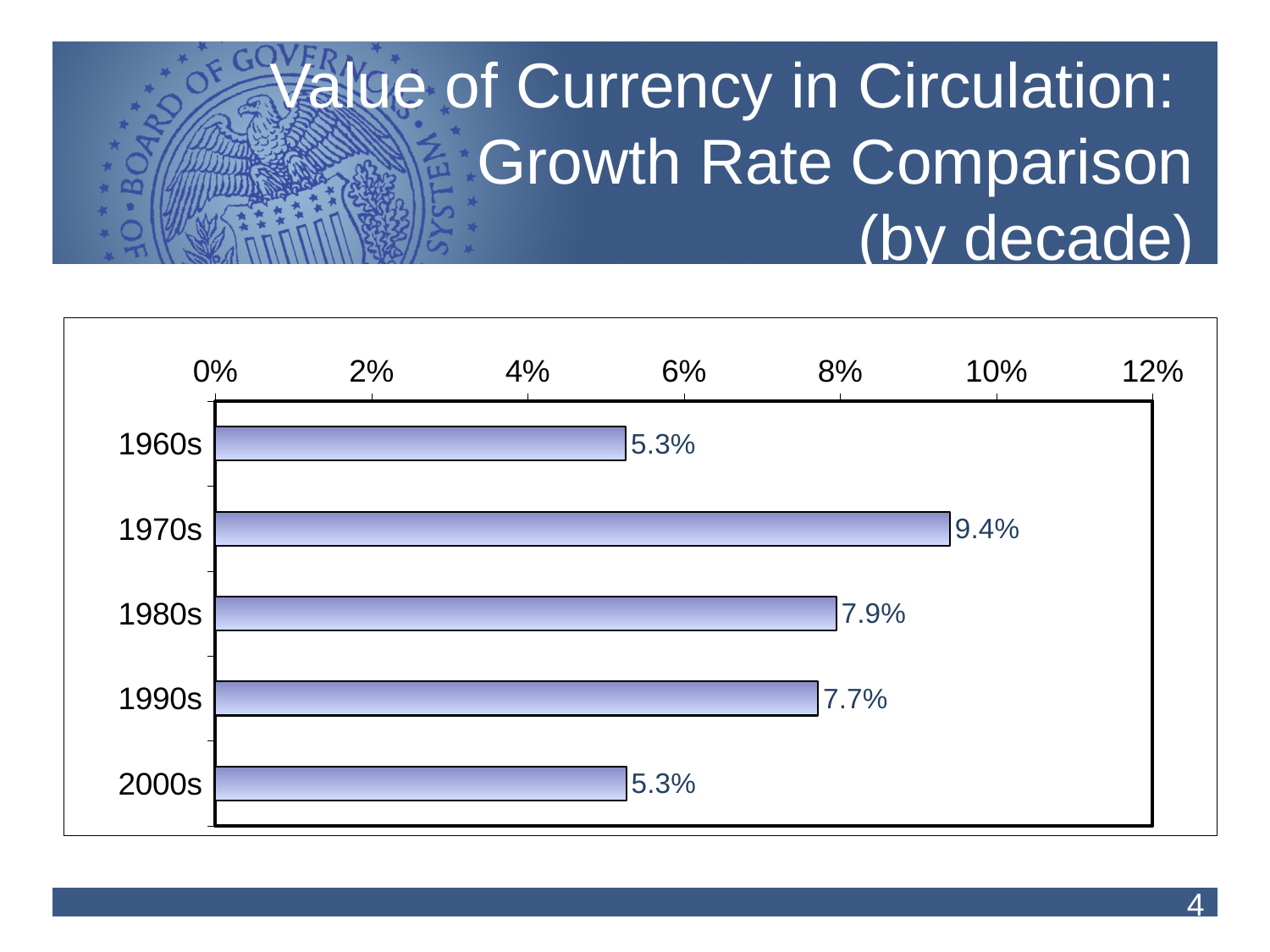
Which is larger, the growth rate for the 1980s or the 2000s? 1980s What is the growth rate shown for the 1980s? 7.9% What is the difference between the growth rates for the 1970s and the 2000s? 4.1% What kind of chart is shown on the slide? bar chart What is the growth rate shown for the 2000s? 5.3% What is the growth rate shown for the 1970s? 9.4% How many decades are shown in the chart? 5 What is the difference between the growth rates for the 1970s and the 1980s? 1.5% Which decade has the highest growth rate? 1970s What is the maximum value shown on the percentage axis? 12% What is the growth rate shown for the 1990s? 7.7% Is the value for the 1970s greater or less than 8%? greater